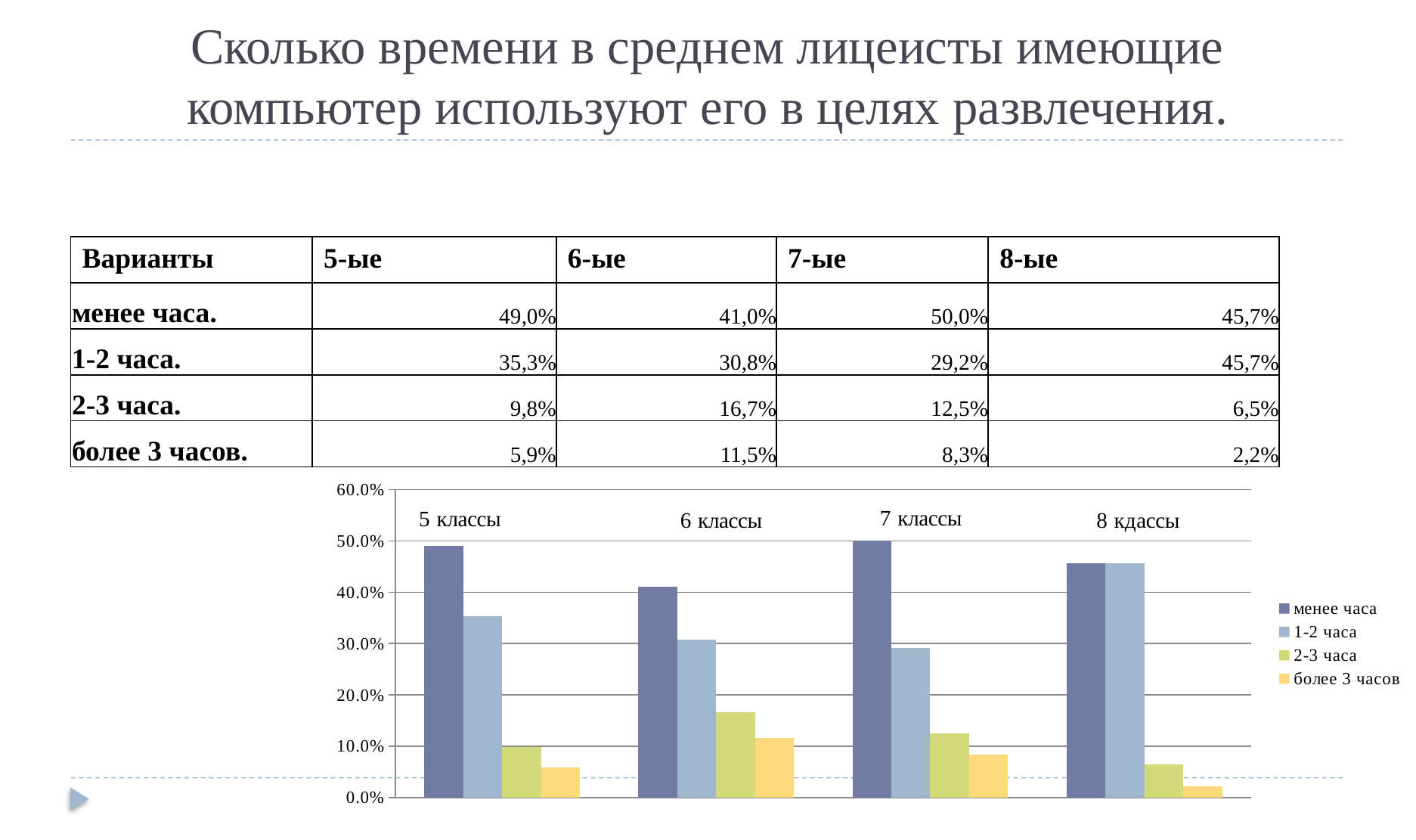
What is the difference between "менее часа" and "1-2 часа" in the 5 классы group? 13,7% What is the value for "более 3 часов" in the 6 классы group? 11,5% Which series has the highest bar in the 6 классы group? менее часа What kind of chart is shown on the slide? bar chart Which is larger: "2-3 часа" in the 6 классы group or "2-3 часа" in the 8 классы group? 6 классы What is the value for "менее часа" in the 5 классы group? 49,0% Which series has the lowest bar in the 8 классы group? более 3 часов What is the highest value shown on the chart's vertical axis? 60.0% Is the value for "2-3 часа" in the 6 классы group greater or less than 20%? less How many class groups are shown along the x axis of the chart? 4 How many series does the chart legend list? 4 Is the value for "1-2 часа" in the 5 классы group greater or less than 30%? greater